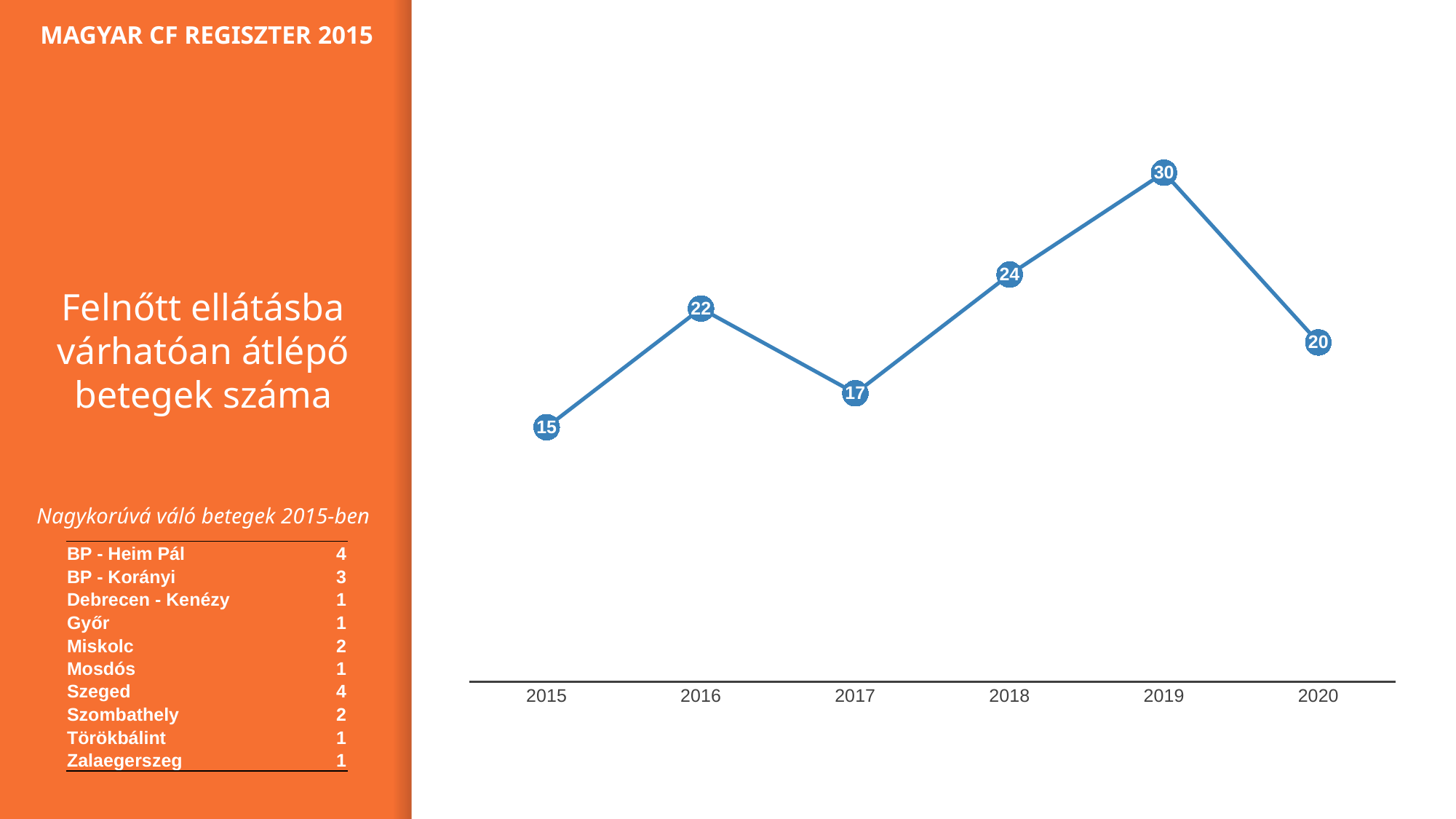
What is the title of the chart on the slide? Felnőtt ellátásba várhatóan átlépő betegek száma What is the value for 2020? 20 What is the value for 2017? 17 What is the difference between the values for 2016 and 2017? 5 How many data points are plotted on the chart? 6 What is the difference between the values for 2019 and 2018? 6 What kind of chart is shown on the slide? line chart Which year has the lowest value? 2015 Which is larger, the value for 2016 or the value for 2020? 2016 Does the value rise or fall from 2019 to 2020? fall Which year has the highest value? 2019 What is the value for 2015? 15